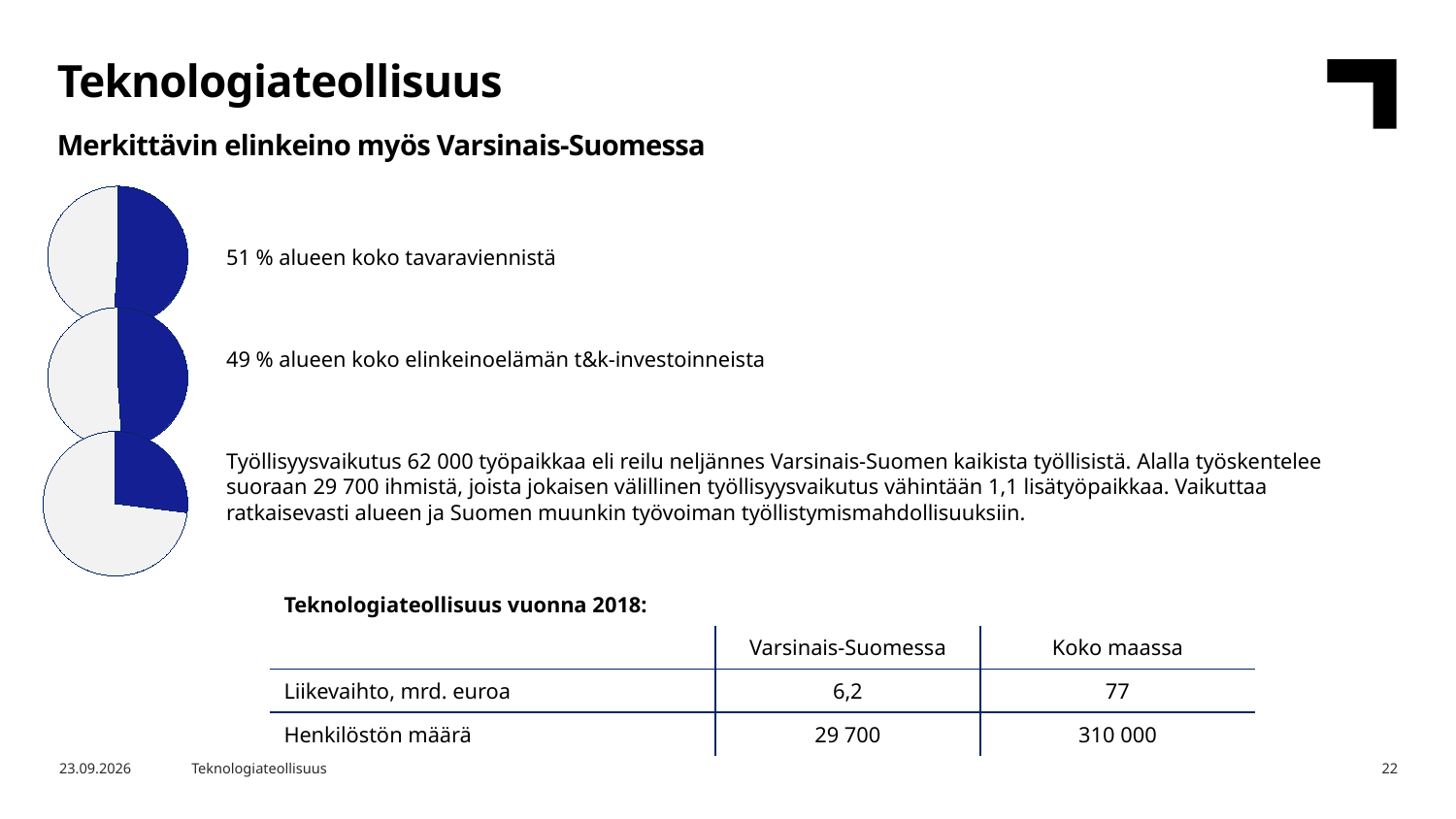
Is the highlighted slice in the top pie chart larger or smaller than the highlighted slice in the bottom pie chart? Larger What kind of charts are shown on the left side of the slide? Pie charts In the middle pie chart, what share of the region's business R&D investments does the highlighted slice represent, according to the text beside it? 49 % What is the title of the slide containing the pie charts? Teknologiateollisuus In the bottom pie chart, is the highlighted (blue) slice greater or less than half of the pie? less What colour is used for the highlighted slice in each pie chart? Blue How many pie charts are shown on the slide? 3 In the top pie chart, what share of the region's total goods exports does the highlighted slice represent, according to the text beside it? 51 % Which of the three pie charts has the smallest highlighted (blue) slice? The bottom pie chart